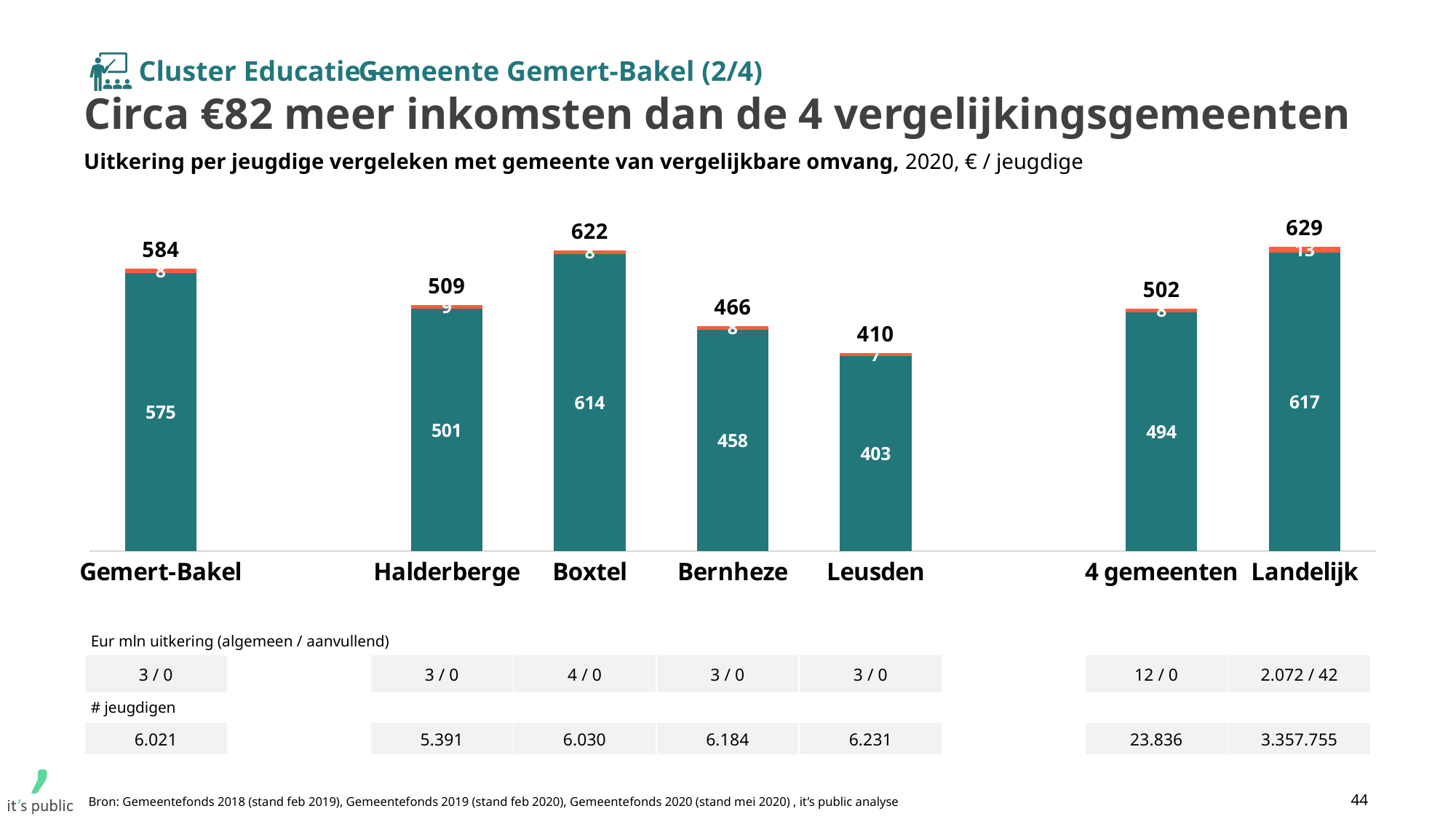
What is the value of the teal (lower) segment of the 4 gemeenten bar? 494 What is the total value shown above the bar for Gemert-Bakel? 584 What is the value of the teal (lower) segment of the Boxtel bar? 614 Which category has the lowest total value? Leusden Which has a larger total, Halderberge or Bernheze? Halderberge What is the total value shown above the bar for Leusden? 410 What is the difference between the total for Gemert-Bakel and the total for 4 gemeenten? 82 How many categories (bars) are shown in the chart? 7 Which category has the highest total value? Landelijk What kind of chart is shown on the slide? Stacked bar chart What is the difference between the total for Boxtel and the total for Bernheze? 156 What is the number of jeugdigen listed below the chart for Halderberge? 5.391